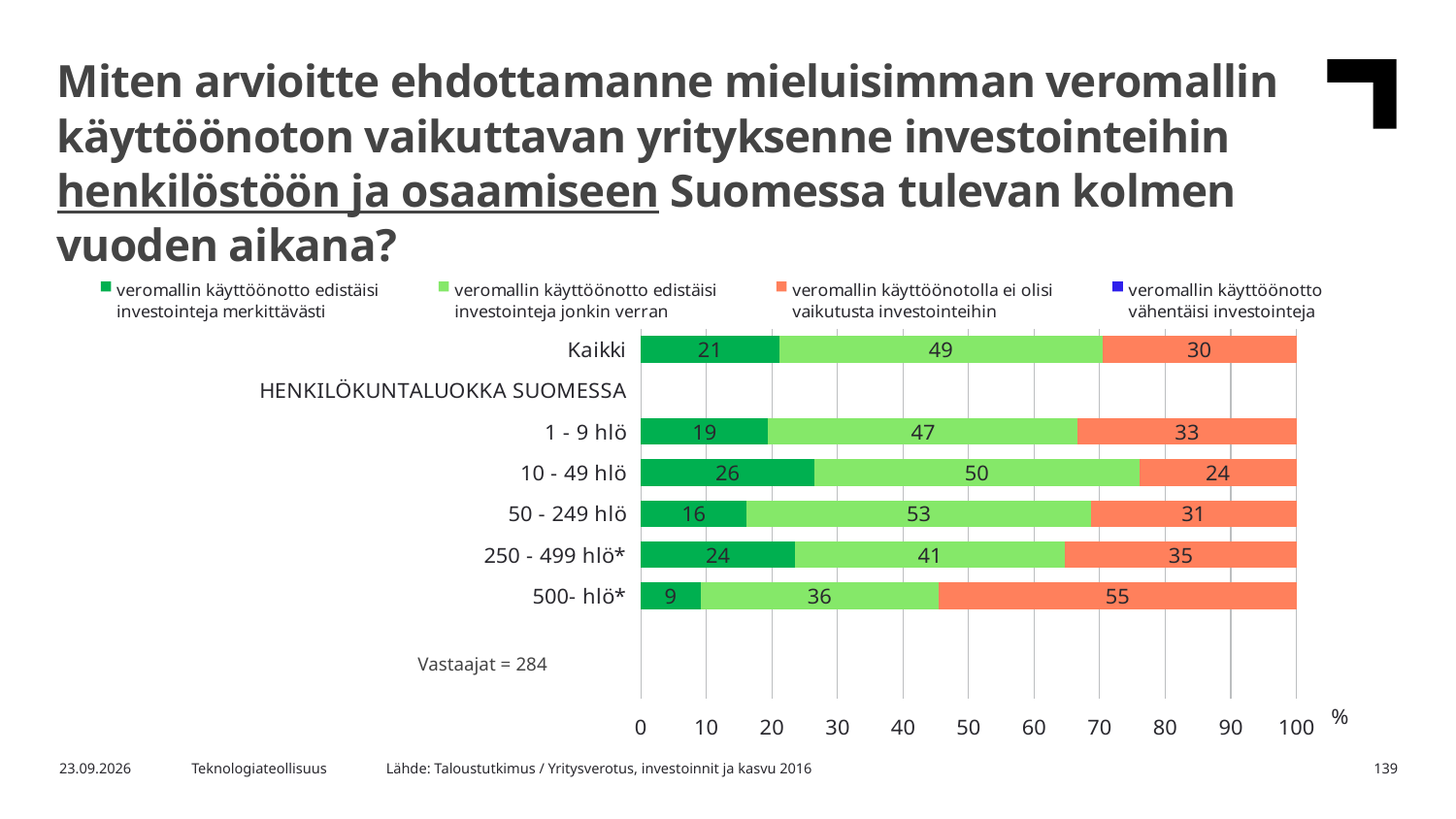
How many series does the legend list? 4 Which is larger: the 'veromallin käyttöönotto edistäisi investointeja merkittävästi' value for 250 - 499 hlö* or for 1 - 9 hlö? 250 - 499 hlö* What is the value for 'veromallin käyttöönotto edistäisi investointeja merkittävästi' in the Kaikki bar? 21 Which category has the highest value for 'veromallin käyttöönotto edistäisi investointeja merkittävästi'? 10 - 49 hlö What is the value for 'veromallin käyttöönotolla ei olisi vaikutusta investointeihin' for 500- hlö*? 55 How many respondents (Vastaajat) are stated on the slide? 284 What is the value for 'veromallin käyttöönotto edistäisi investointeja jonkin verran' for 50 - 249 hlö? 53 What is the total of the stacked bar for 1 - 9 hlö? 99 What kind of chart is shown on the slide? stacked bar chart How many bars with data are plotted in the chart? 6 Which category has the lowest value for 'veromallin käyttöönotto edistäisi investointeja jonkin verran'? 500- hlö* What is the difference between the 'veromallin käyttöönotolla ei olisi vaikutusta investointeihin' values for 500- hlö* and 10 - 49 hlö? 31